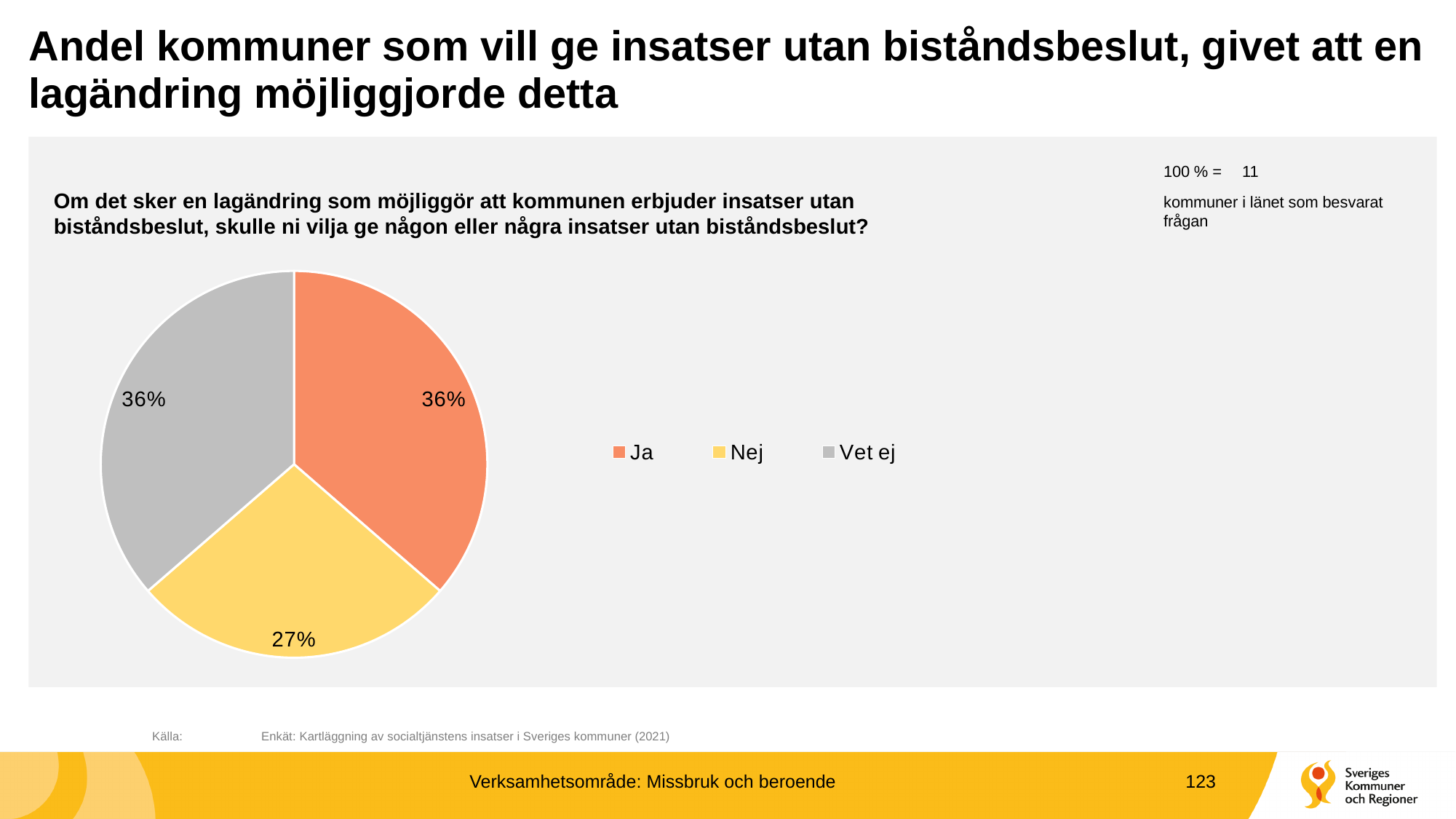
What share of the pie does the "Nej" slice represent? 27% What are the legend entries of the pie chart, in order? Ja, Nej, Vet ej What percentage of the pie chart is the "Ja" slice? 36% Which category has the smallest slice in the pie chart? Nej What percentage of the pie chart is the "Nej" slice? 27% What colour is the "Ja" slice in the pie chart? Orange Which slice is larger, "Ja" or "Nej"? Ja How many slices does the pie chart have? 3 What percentage of the pie chart is the "Vet ej" slice? 36% How many entries does the legend of the pie chart list? 3 What is the difference in percentage points between the "Ja" slice and the "Nej" slice? 9 percentage points What kind of chart is shown on the slide? Pie chart